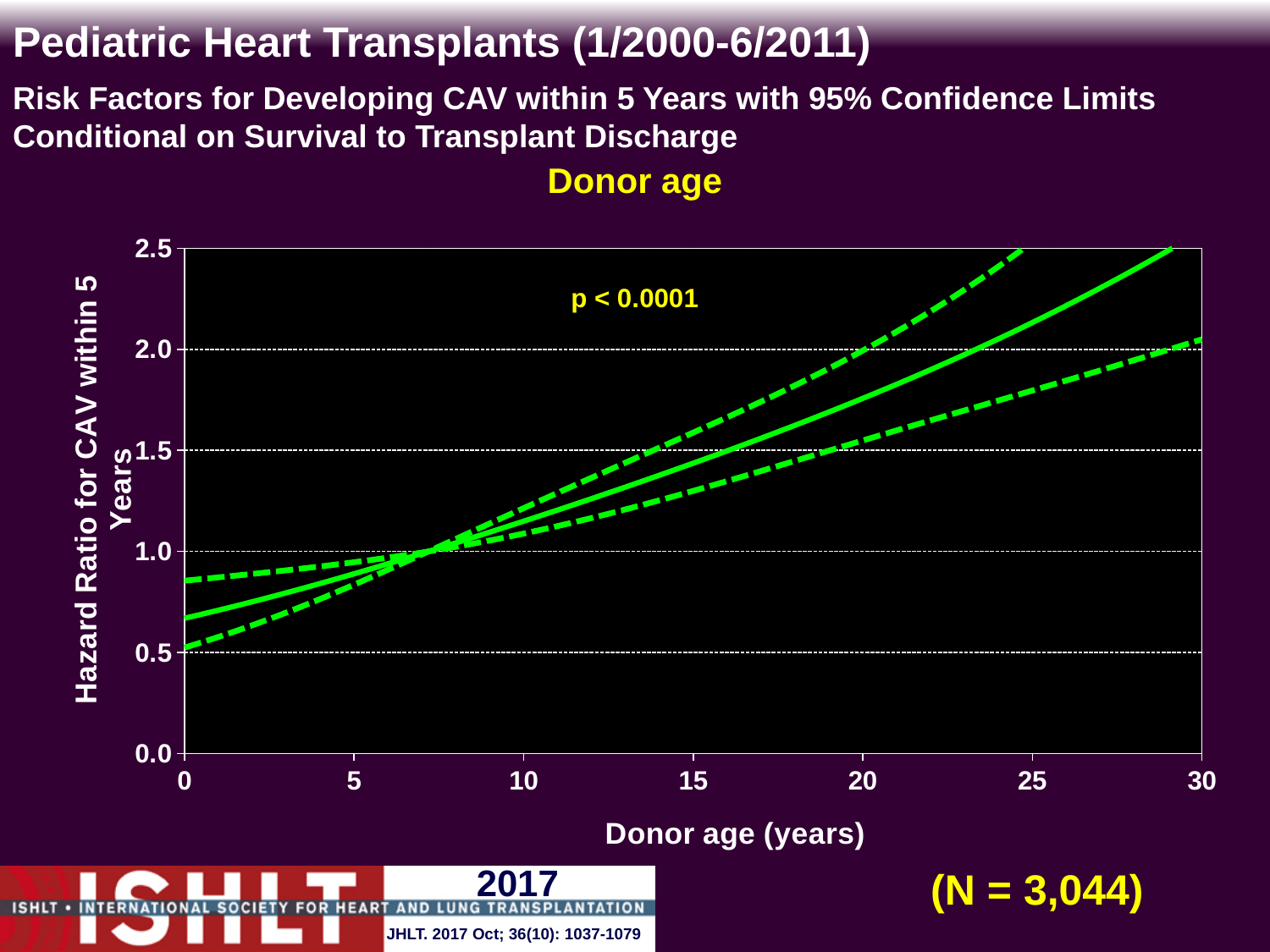
What kind of chart is shown on the slide? line chart Is the hazard ratio (solid line) at donor age 30 years greater or less than 2.0? greater Is the upper 95% confidence limit (upper dashed line) at donor age 0 greater or less than 1.0? less Is the upper 95% confidence limit (upper dashed line) at donor age 25 years greater or less than 2.0? greater What is the p-value shown on the chart? p < 0.0001 What is the highest donor age shown on the x axis? 30 Does the hazard ratio for CAV within 5 years rise or fall as donor age increases? rise What is the label of the x axis? Donor age (years) What is the highest value shown on the y axis? 2.5 How many lines are plotted on the chart? 3